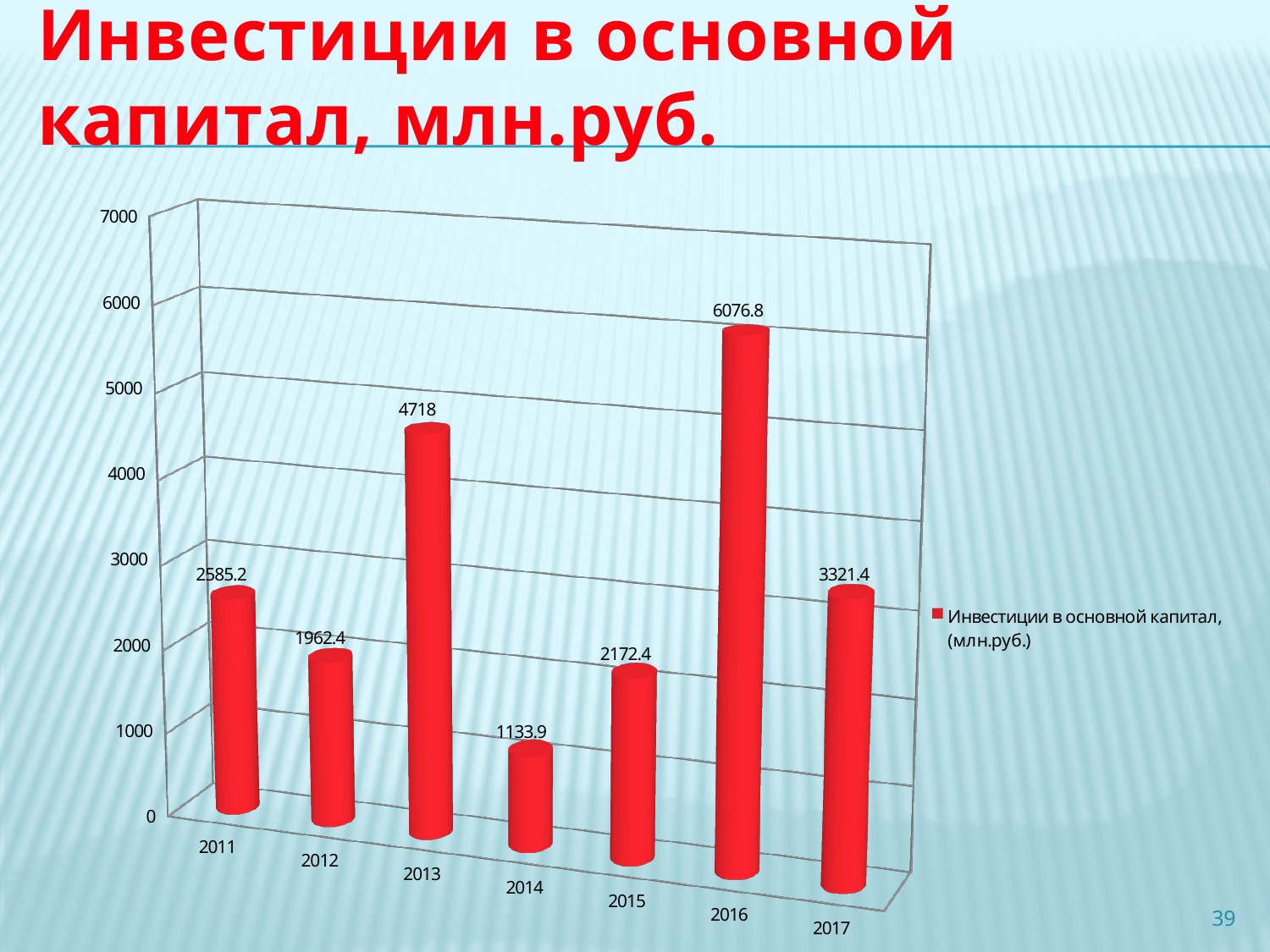
Which year has the highest value? 2016 Which is larger, the value for 2012 or the value for 2015? 2015 What is the value for 2016? 6076.8 What kind of chart is this? bar chart What is the difference between the values for 2016 and 2017? 2755.4 How many years are shown on the x axis? 7 What is the value for 2014? 1133.9 Which year has the lowest value? 2014 What is the value for 2013? 4718 What is the legend entry for the series? Инвестиции в основной капитал, (млн.руб.) What is the value for 2011? 2585.2 Is the value for 2017 greater or less than 3000? greater